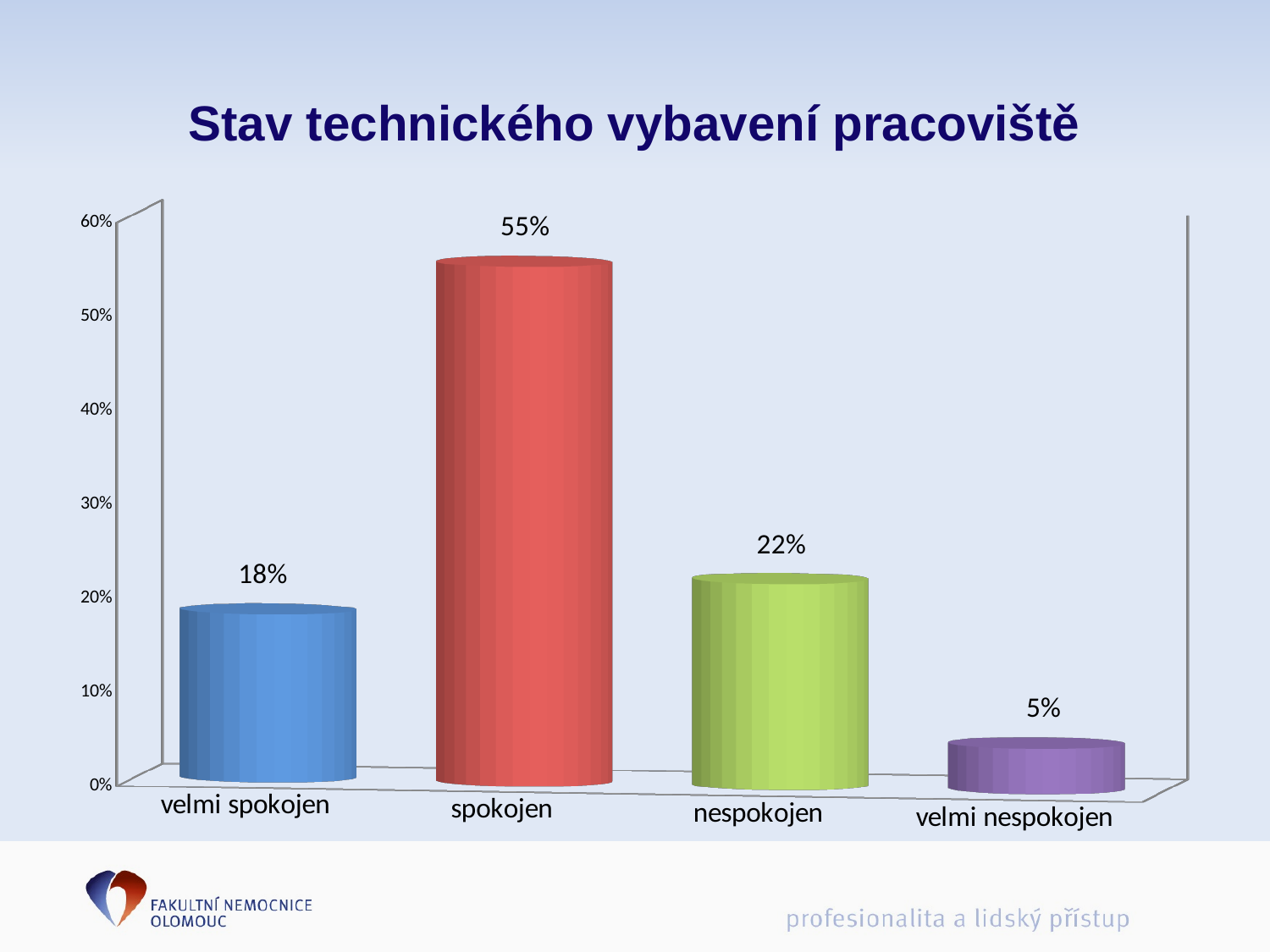
What is the value for "spokojen"? 55% What is the difference between the values for "velmi spokojen" and "velmi nespokojen"? 13% What is the value for "nespokojen"? 22% What is the value for "velmi nespokojen"? 5% Which is larger, the value for "nespokojen" or the value for "velmi spokojen"? nespokojen Which category has the lowest value? velmi nespokojen Which category has the highest value? spokojen What is the title of the chart? Stav technického vybavení pracoviště What is the value for "velmi spokojen"? 18% What kind of chart is shown on the slide? bar chart How many categories are shown on the x axis? 4 What is the difference between the values for "spokojen" and "nespokojen"? 33%